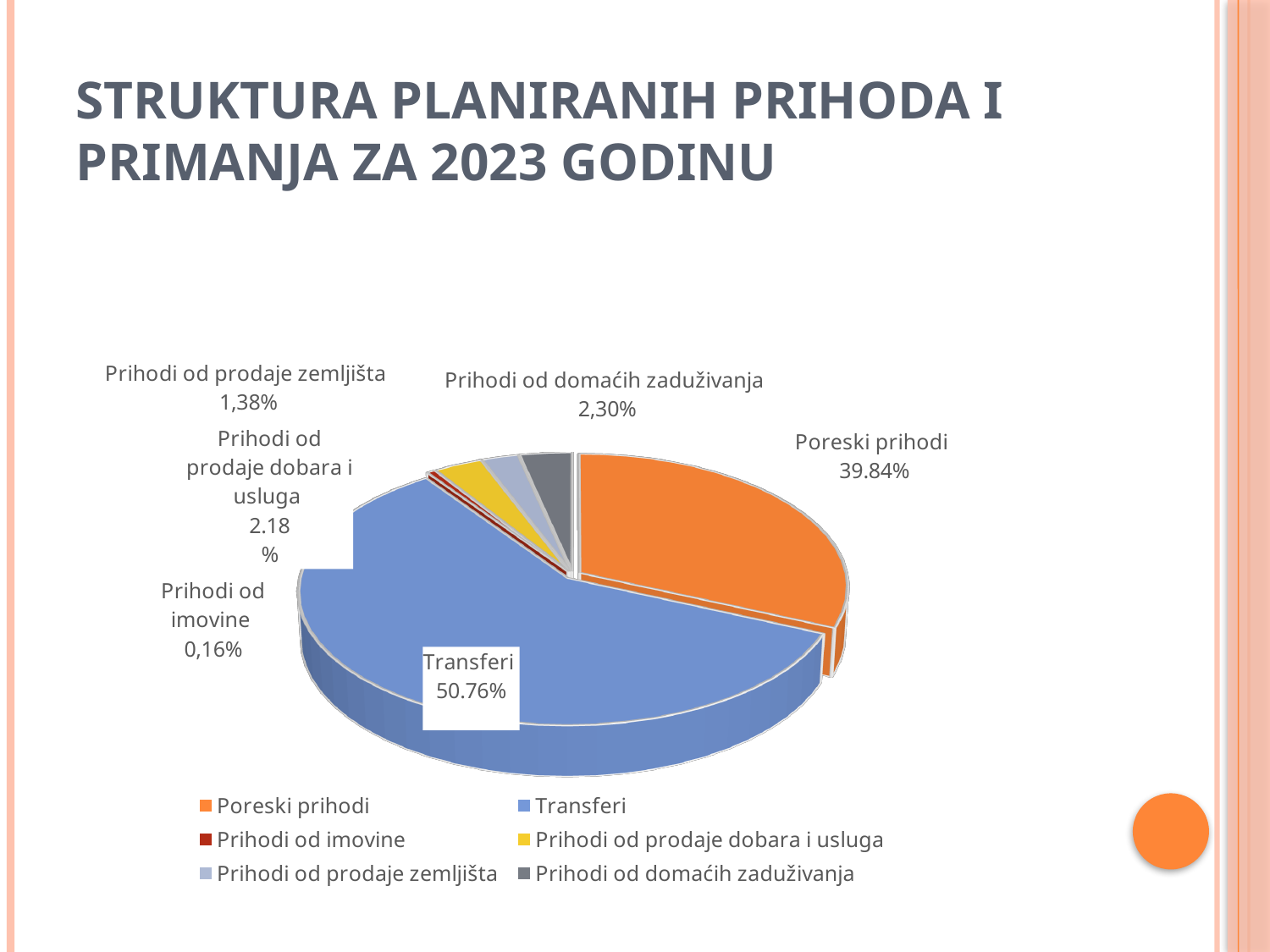
What share of the pie does Transferi have? 50.76% Which category has the largest slice of the pie? Transferi Which category has the smallest slice of the pie? Prihodi od imovine What percentage is shown for Prihodi od imovine? 0,16% Which is larger, Prihodi od prodaje dobara i usluga or Prihodi od domaćih zaduživanja? Prihodi od domaćih zaduživanja How many categories does the pie chart show? 6 What is the value shown for Poreski prihodi? 39.84% What percentage is shown for Prihodi od domaćih zaduživanja? 2,30% By how many percentage points does Transferi exceed Poreski prihodi? 10.92 What kind of chart is shown on the slide? pie chart What colour is the Transferi slice in the pie chart? blue What is the value labelled for Prihodi od prodaje zemljišta? 1,38%